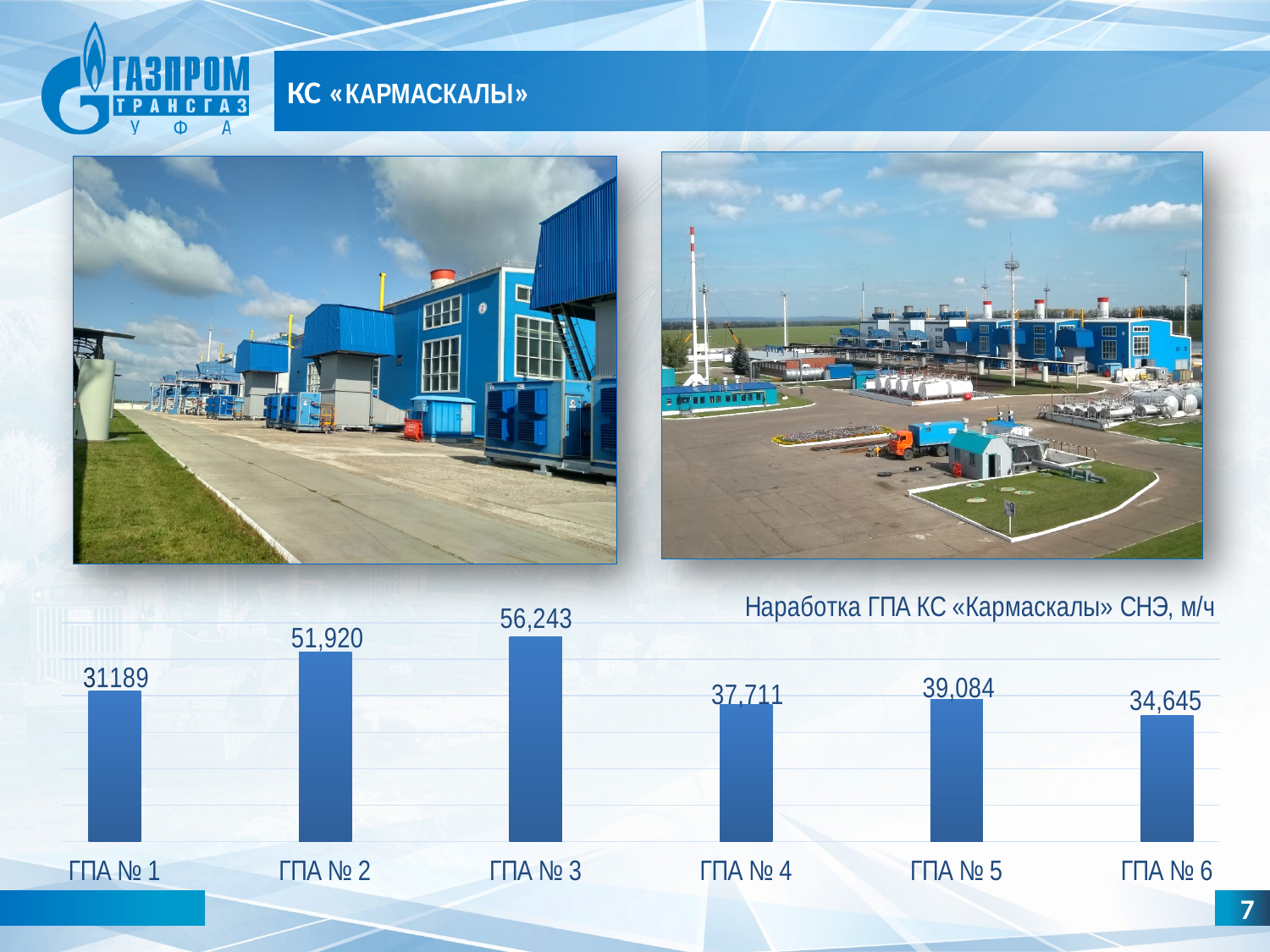
What is the value for ГПА № 6? 34,645 Which is larger, the value for ГПА № 2 or the value for ГПА № 4? ГПА № 2 What is the difference between the values for ГПА № 3 and ГПА № 2? 4,323 What is the title of the chart? Наработка ГПА КС «Кармаскалы» СНЭ, м/ч What is the value for ГПА № 1? 31189 Which category has the highest value? ГПА № 3 What is the value for ГПА № 5? 39,084 What is the value for ГПА № 3? 56,243 What kind of chart is shown on the slide? Bar chart What is the difference between the values for ГПА № 5 and ГПА № 4? 1,373 How many categories are shown in the chart? 6